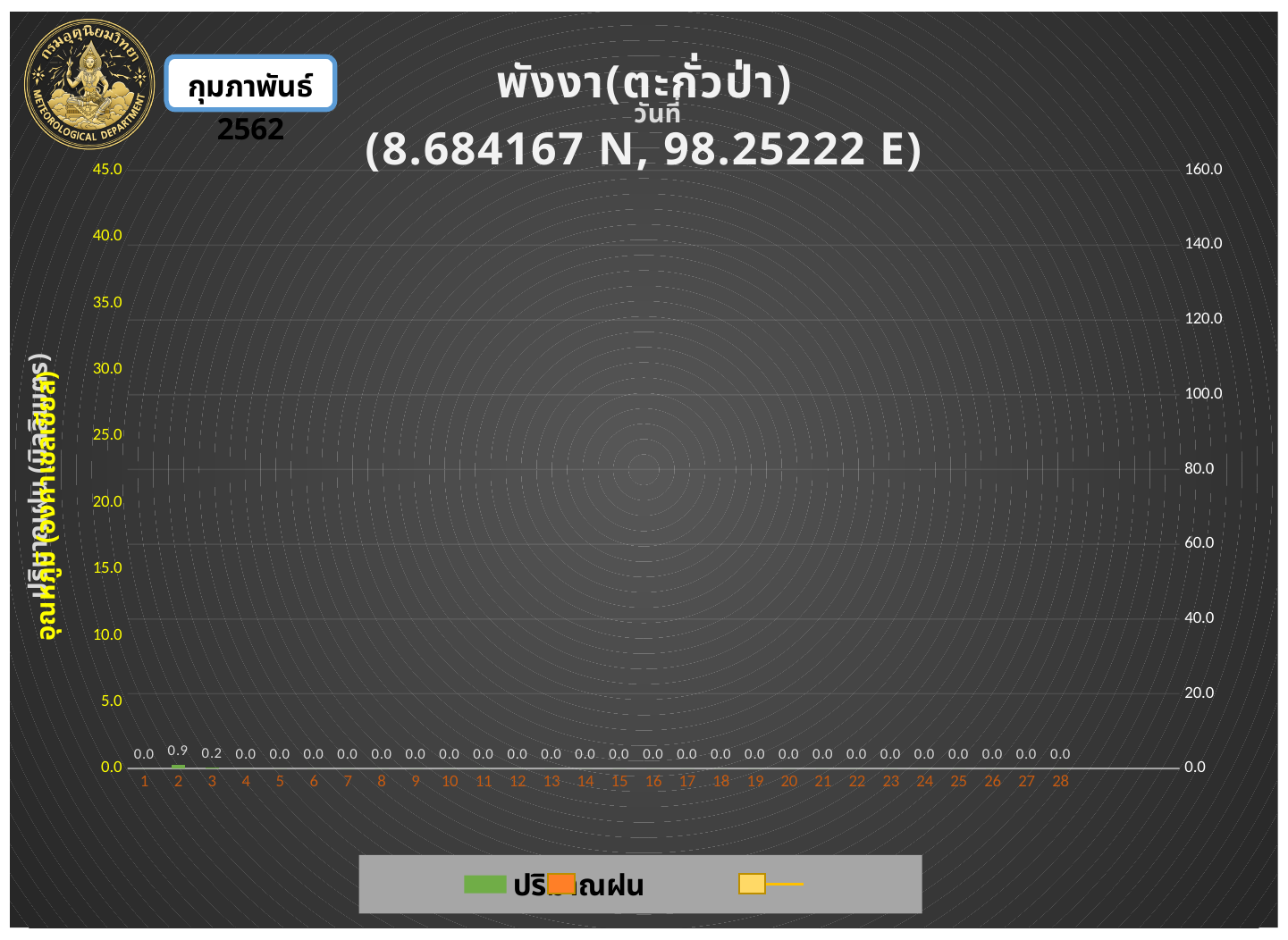
What is the difference between the rainfall values for day 2 and day 3? 0.7 What is the rainfall value shown for day 2? 0.9 What kind of chart is used to show the rainfall values? bar chart What is the highest tick value on the left vertical axis? 45.0 Which has the larger rainfall value, day 2 or day 3? day 2 What is the rainfall value shown for day 3? 0.2 Which day has the highest rainfall value? 2 What is the total rainfall for days 1, 2 and 3 combined? 1.1 Is the rainfall value for day 2 greater or less than 5.0? less What coordinates are given in the chart title? 8.684167 N, 98.25222 E What is the rainfall value shown for day 10? 0.0 How many days are shown on the x axis? 28